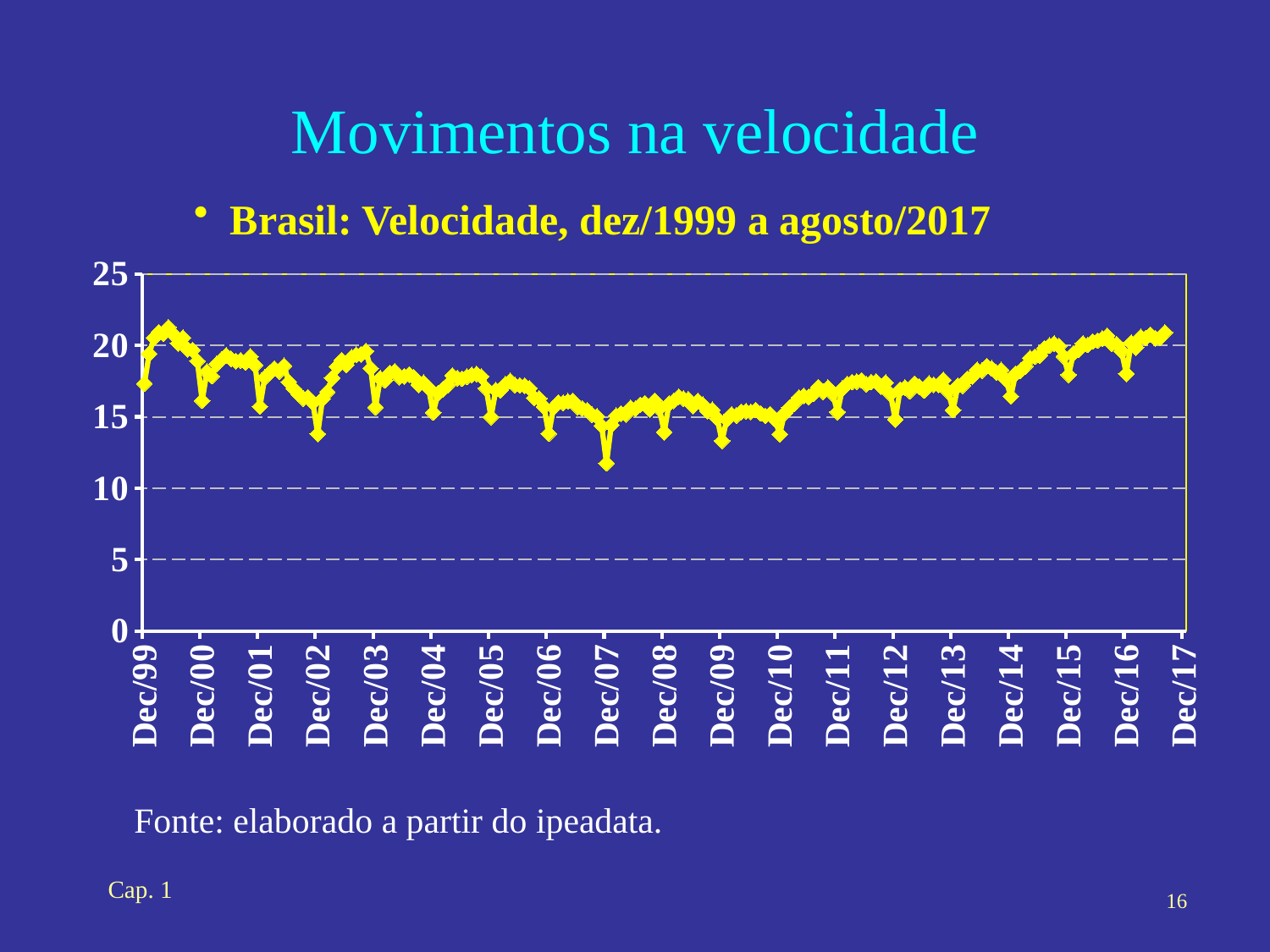
How many labels are shown along the horizontal axis of the chart? 19 Does the series generally rise or fall between Dec/07 and Dec/16? rise Is the value at Dec/15 greater or less than 15? greater What is the highest value shown on the vertical axis of the chart? 25 Is the value at Dec/16 greater or less than 15? greater Is the value at Dec/09 greater or less than 15? less What kind of chart is shown on the slide? line chart What is the title of the chart on the slide? Brasil: Velocidade, dez/1999 a agosto/2017 Does the series generally rise or fall between Dec/99 and Dec/07? fall Around which x-axis label does the series reach its lowest point? Dec/07